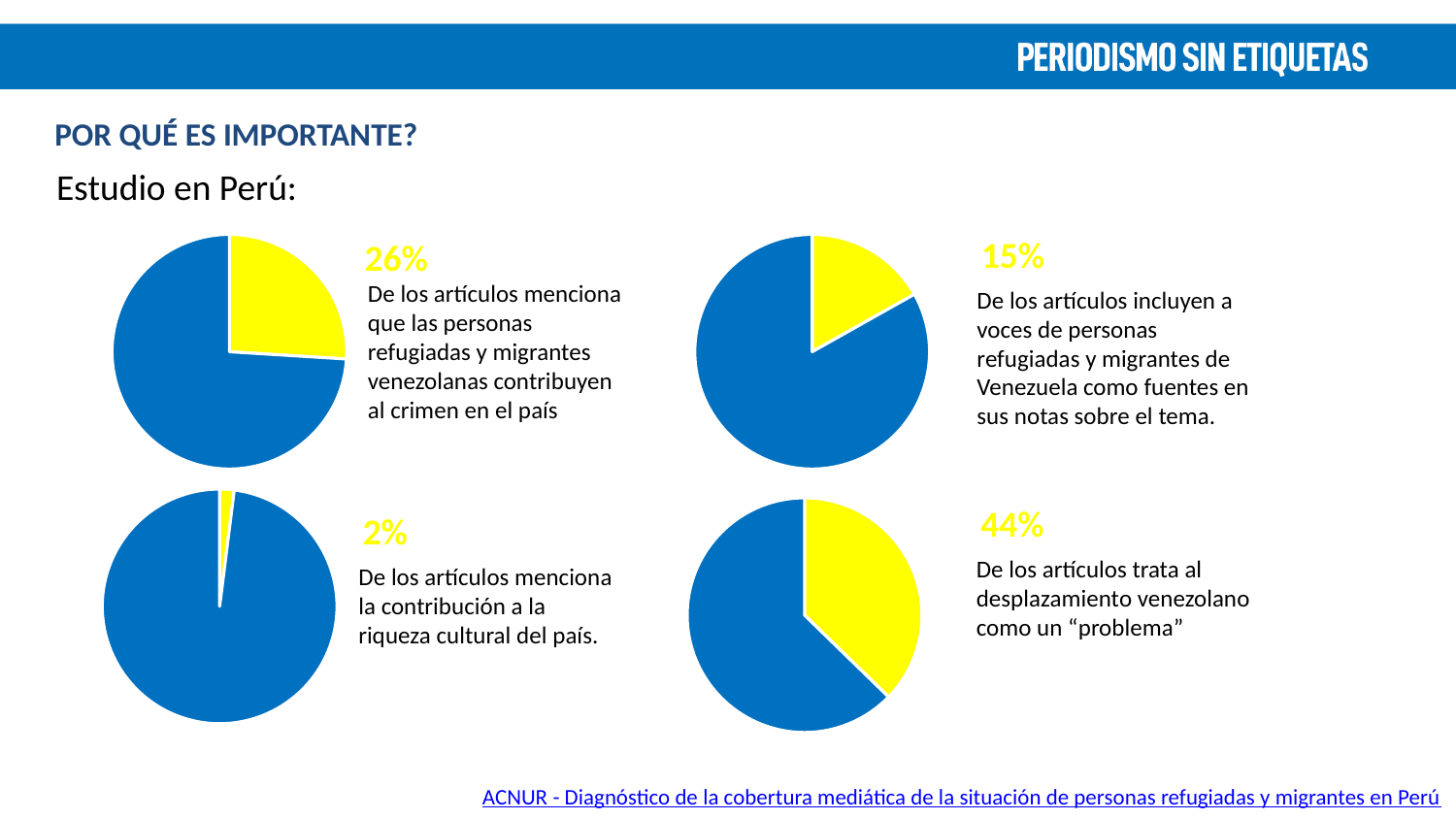
Across the four pie charts, which statistic has the largest highlighted share? 44% (articles treating displacement as a "problem") Which is larger: the share of articles mentioning contribution to crime (top-left pie) or the share including Venezuelan voices as sources (top-right pie)? Contribution to crime (26%) What is the difference between the percentage in the bottom-right pie chart (44%) and the percentage in the top-left pie chart (26%)? 18 percentage points How many pie charts are on the slide? 4 What colour is used for the highlighted slice in each pie chart? Yellow In the bottom-right pie chart, what percentage of articles treat Venezuelan displacement as a "problem"? 44% What kind of charts are shown on the slide? Pie charts In the bottom-left pie chart, what percentage of articles mention the contribution to the cultural richness of the country? 2% In the top-left pie chart, what percentage of articles mention that Venezuelan refugees and migrants contribute to crime in the country? 26% Across the four pie charts, which statistic has the smallest highlighted share? 2% (articles mentioning contribution to cultural richness) In the top-right pie chart, what percentage of articles include the voices of Venezuelan refugees and migrants as sources? 15% In the bottom-left pie chart, what share of the pie does the yellow slice represent? 2%